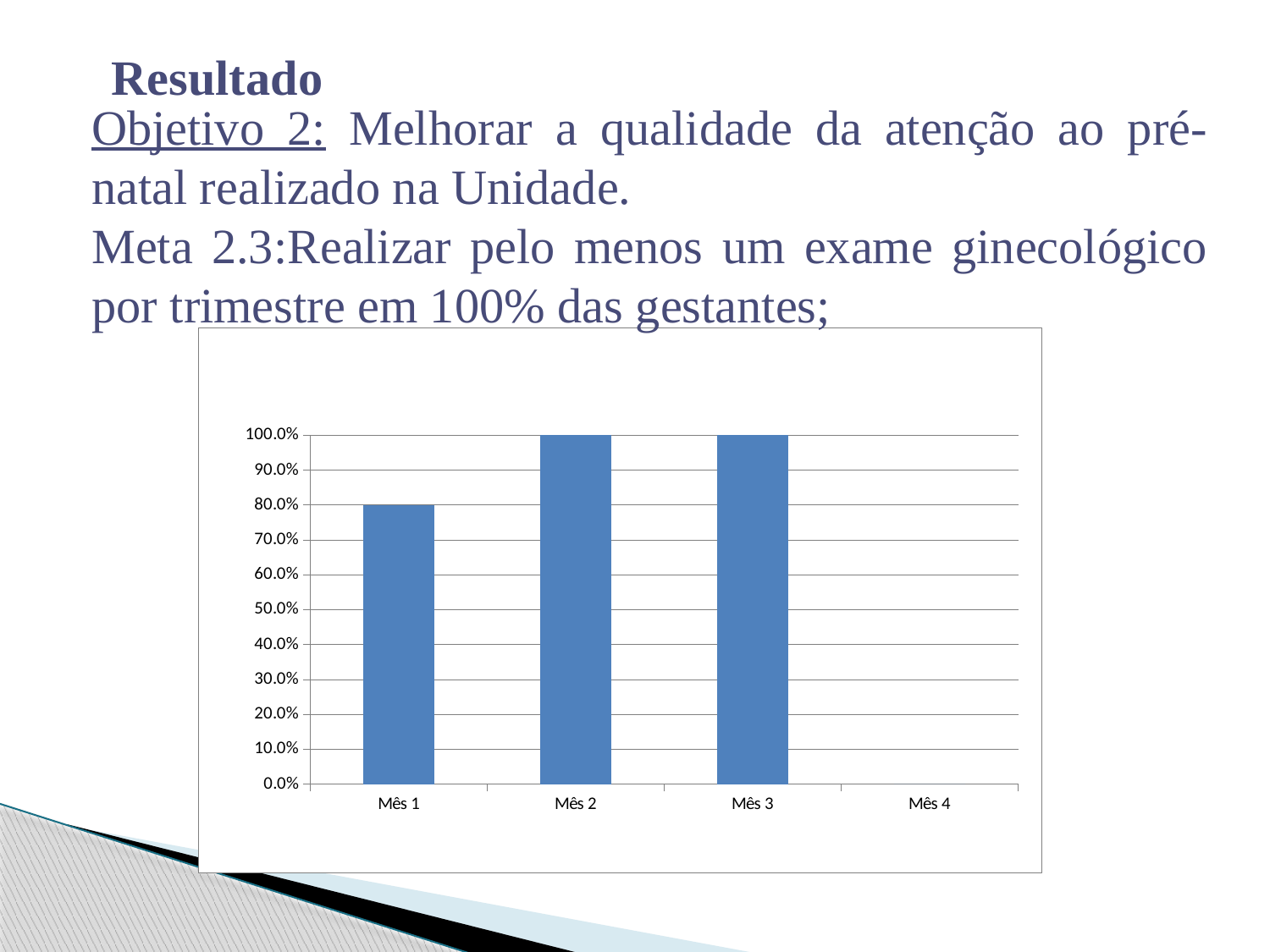
What is the value for Mês 2? 100.0% Does the value rise or fall from Mês 1 to Mês 2? rise What is the value for Mês 3? 100.0% What colour are the bars in the chart? blue What is the value for Mês 1? 80.0% Which is larger, the value for Mês 1 or the value for Mês 2? Mês 2 Is the value for Mês 3 greater or less than 50.0%? greater What is the difference between the values for Mês 2 and Mês 1? 20.0% How many categories are shown on the x axis? 4 What kind of chart is shown on the slide? bar chart Is the value for Mês 1 greater or less than 90.0%? less What is the highest value shown on the y axis? 100.0%